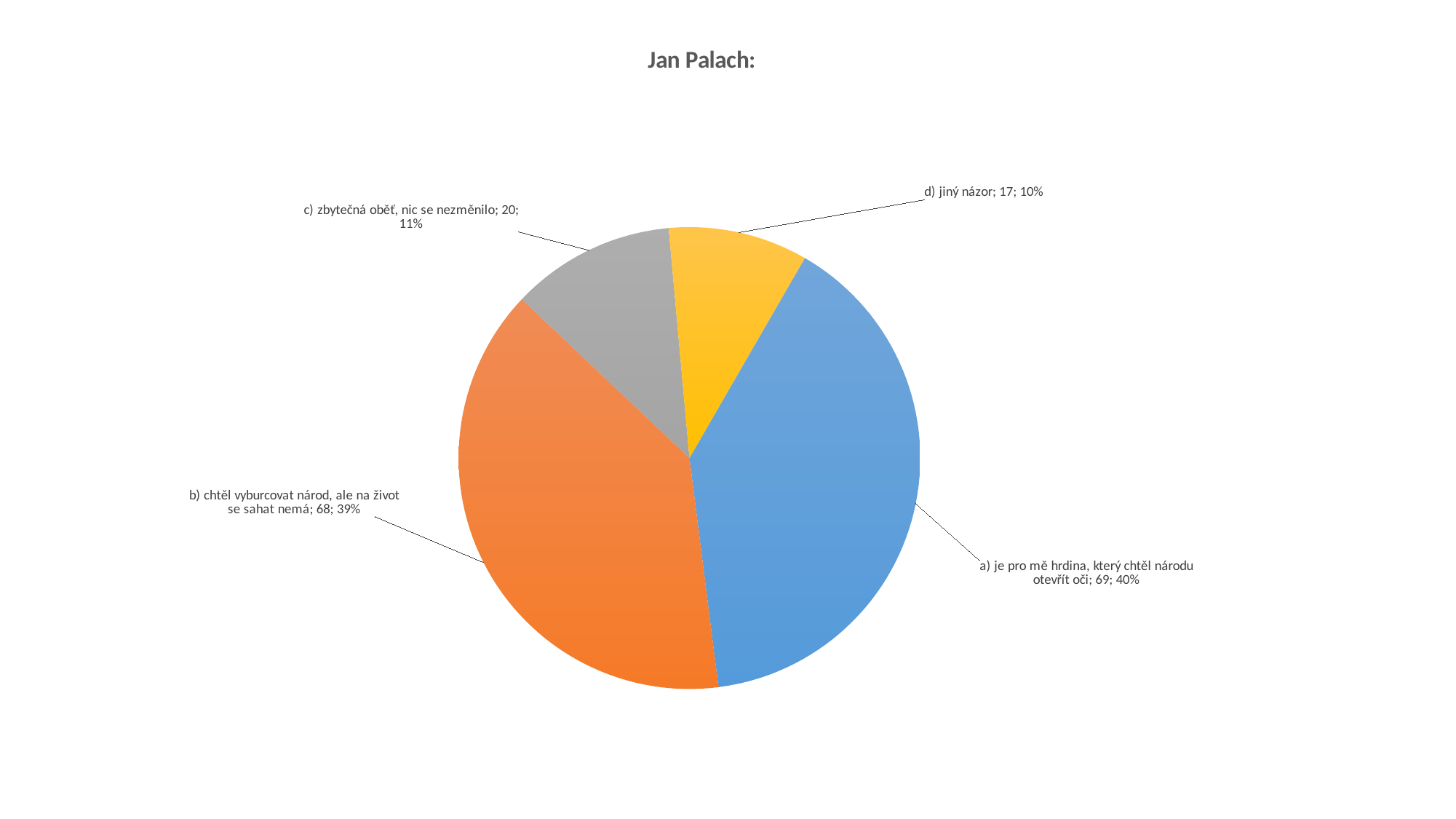
What is the count for the slice "a) je pro mě hrdina, který chtěl národu otevřít oči"? 69 What percentage share does the slice "d) jiný názor" have? 10% What is the count for the slice "b) chtěl vyburcovat národ, ale na život se sahat nemá"? 68 Which slice is larger: "c) zbytečná oběť, nic se nezměnilo" or "d) jiný názor"? c) zbytečná oběť, nic se nezměnilo What type of chart is shown on the slide? pie chart Which slice has the smallest count? d) jiný názor How many slices does the pie chart have? 4 What is the count for the slice "c) zbytečná oběť, nic se nezměnilo"? 20 What is the title of the chart? Jan Palach: What percentage share does the slice "c) zbytečná oběť, nic se nezměnilo" have? 11% What is the difference between the counts for "b) chtěl vyburcovat národ, ale na život se sahat nemá" and "c) zbytečná oběť, nic se nezměnilo"? 48 Which slice has the largest count? a) je pro mě hrdina, který chtěl národu otevřít oči